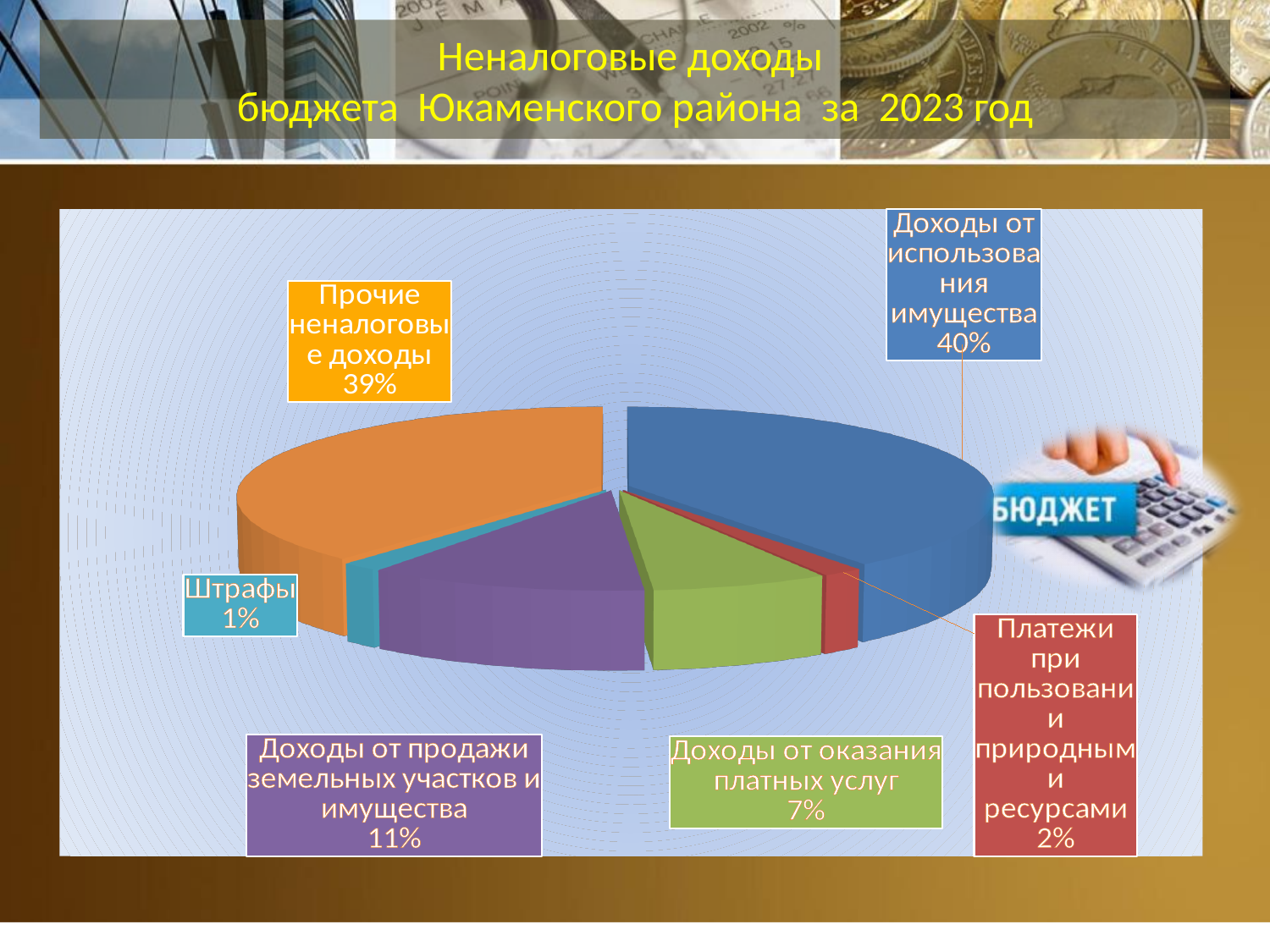
What share is labelled for "Доходы от оказания платных услуг"? 7% How many categories (slices) does the pie chart have? 6 What is the value for "Доходы от продажи земельных участков и имущества"? 11% What kind of chart is shown on the slide? pie chart What share of non-tax revenue comes from "Доходы от использования имущества"? 40% Which is larger: the share for "Платежи при пользовании природными ресурсами" or the share for "Штрафы"? Платежи при пользовании природными ресурсами What percentage is shown for "Штрафы"? 1% What is the difference between the shares of "Доходы от продажи земельных участков и имущества" and "Доходы от оказания платных услуг"? 4% Which category has the smallest share of the pie? Штрафы What is the value shown for "Прочие неналоговые доходы"? 39% Which category has the largest share of the pie? Доходы от использования имущества What percentage is shown for "Платежи при пользовании природными ресурсами"? 2%